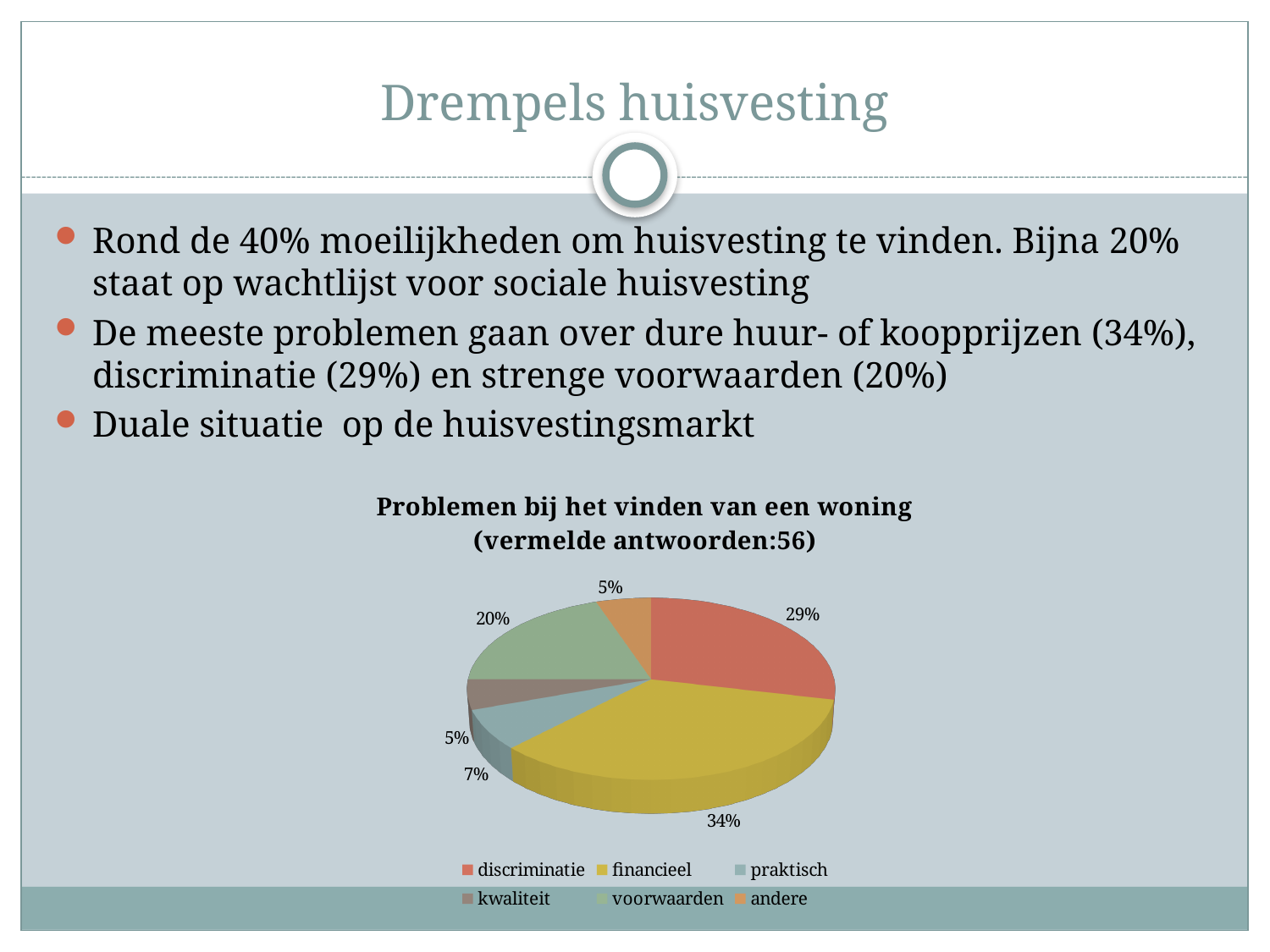
What colour is the 'financieel' slice? yellow Which slice is larger, 'discriminatie' or 'voorwaarden'? discriminatie What percentage of the pie is the 'praktisch' slice? 7% What percentage of the pie is the 'discriminatie' slice? 29% What percentage of the pie is the 'financieel' slice? 34% Which category has the largest slice of the pie? financieel How many categories does the legend list? 6 What is the difference in percentage points between the 'financieel' and 'discriminatie' slices? 5 What is the title of the chart? Problemen bij het vinden van een woning (vermelde antwoorden:56) What percentage of the pie is the 'kwaliteit' slice? 5% What kind of chart is shown on the slide? pie chart What percentage of the pie is the 'voorwaarden' slice? 20%